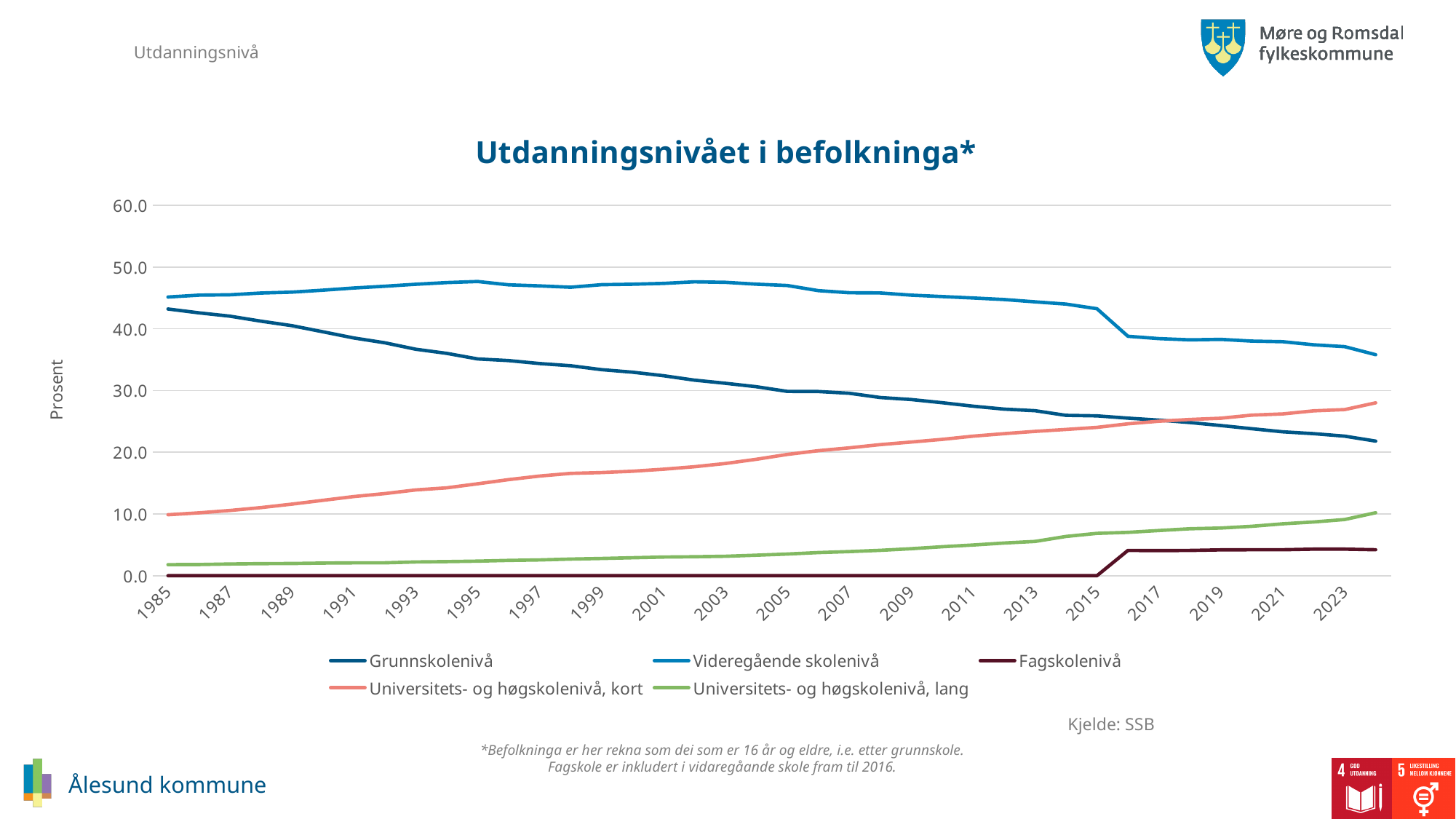
Is the value for Universitets- og høgskolenivå, kort in 2023 greater or less than 20? greater What is the label on the y axis? Prosent Does the Grunnskolenivå line rise or fall from 1985 to 2023? fall What is the title of the chart? Utdanningsnivået i befolkninga* Does the Universitets- og høgskolenivå, kort line rise or fall from 1985 to 2023? rise In 2023, which is higher: Grunnskolenivå or Universitets- og høgskolenivå, kort? Universitets- og høgskolenivå, kort How many series does the legend list? 5 Which series has the lowest value in 2023? Fagskolenivå Is the value for Videregående skolenivå in 2023 greater or less than 40? less Which series has the highest value in 2023? Videregående skolenivå Is the value for Grunnskolenivå in 1985 greater or less than 40? greater What kind of chart is shown on the slide? line chart